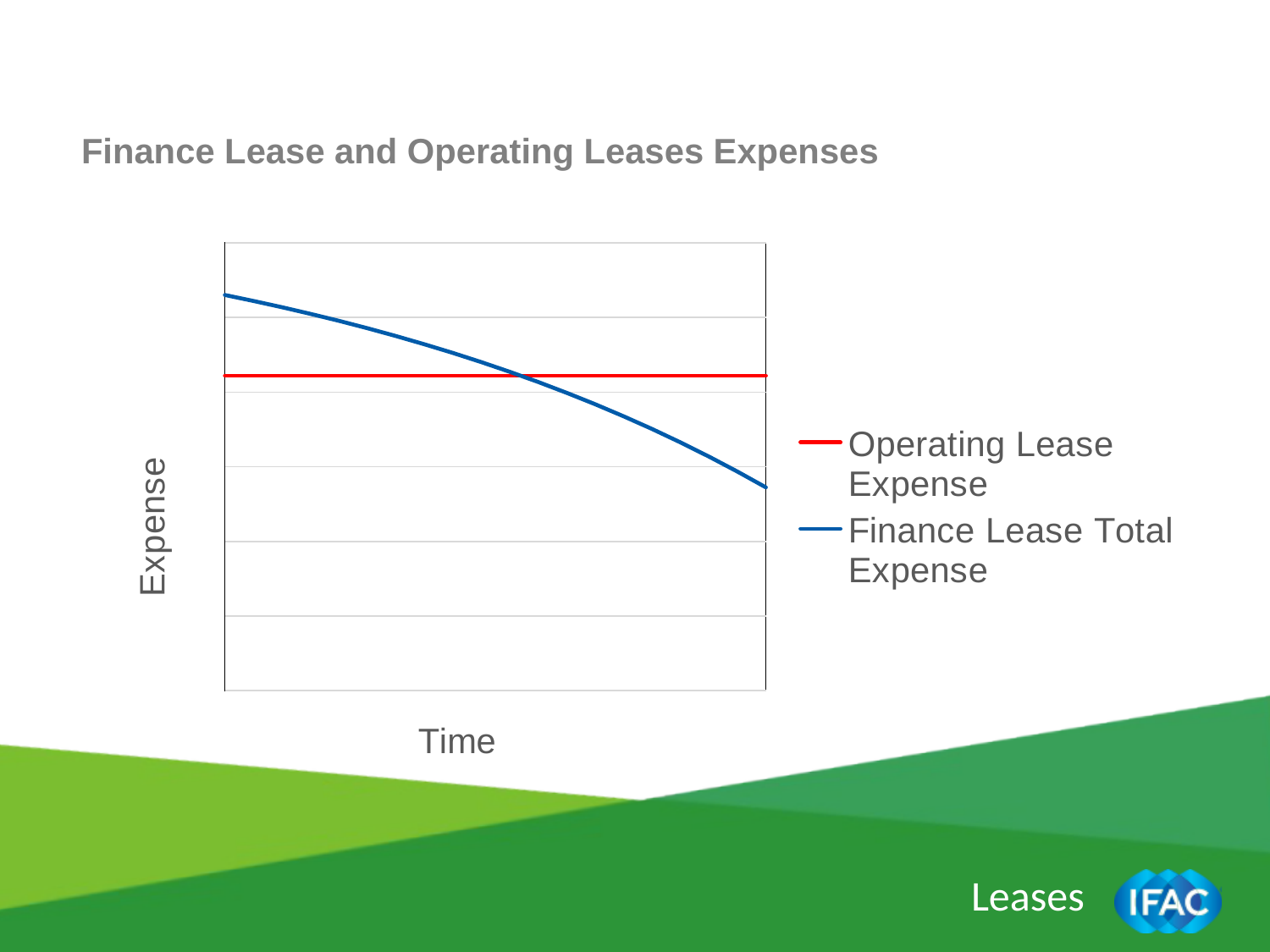
What is the label on the vertical axis? Expense Does the Finance Lease Total Expense line rise or fall over time? Fall What is the title of the chart? Finance Lease and Operating Leases Expenses Does the Operating Lease Expense line rise, fall, or stay flat over time? Stay flat At the start of the time axis, which series is higher: Operating Lease Expense or Finance Lease Total Expense? Finance Lease Total Expense How many series does the legend list? 2 At the end of the time axis, which series is higher: Operating Lease Expense or Finance Lease Total Expense? Operating Lease Expense What colour is the Finance Lease Total Expense line? Blue What kind of chart is shown on the slide? Line chart